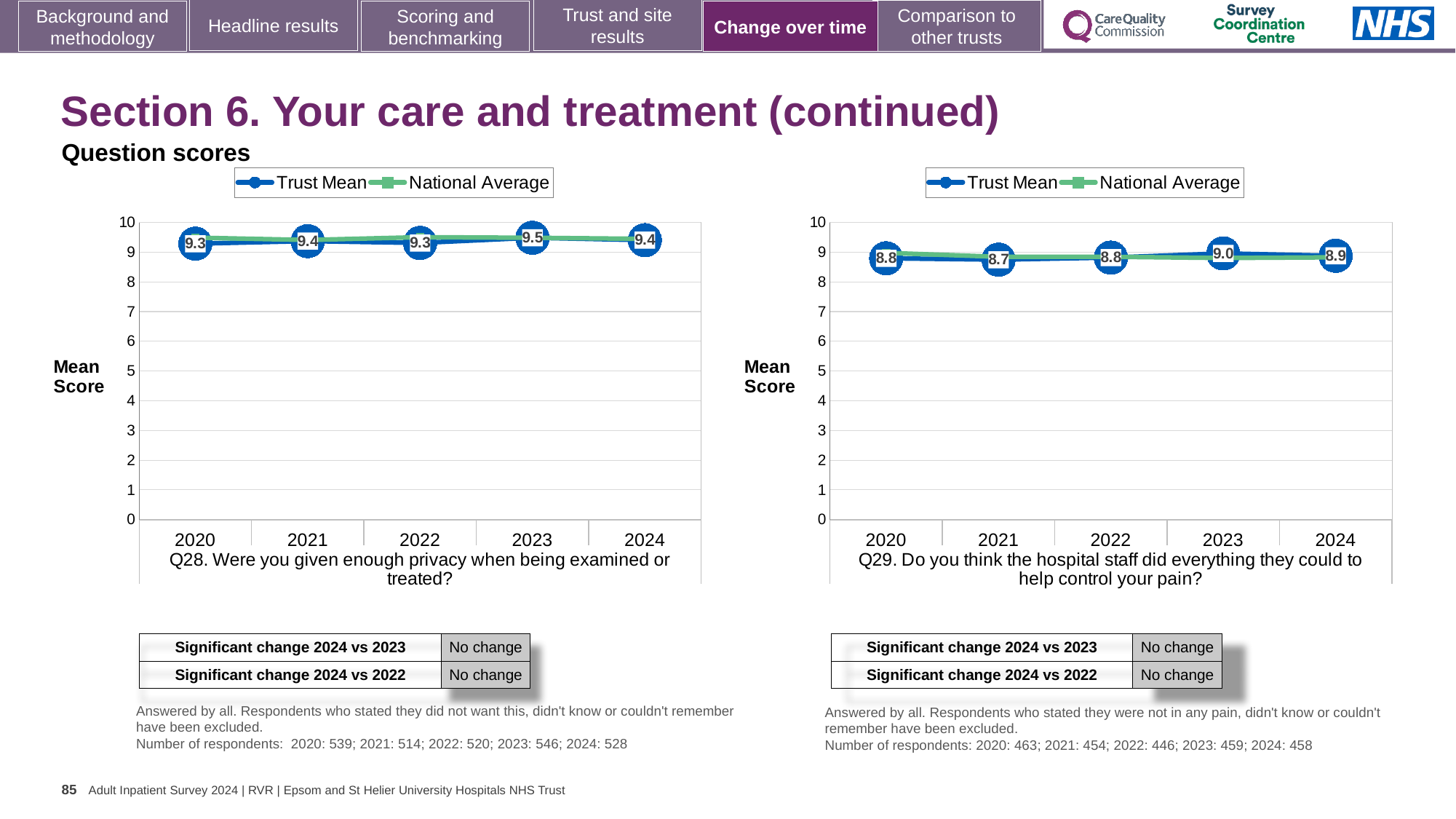
In the Q29 chart (right), what is the Trust Mean score for 2021? 8.7 In the Q28 chart (left), what is the Trust Mean score for 2023? 9.5 In the Q28 chart (left), what is the Trust Mean score for 2020? 9.3 What type of chart is used for Q28 (left)? Line chart In the Q28 chart (left), is the Trust Mean score for 2024 higher or lower than for 2023? lower In the Q28 chart (left), which year has the highest Trust Mean score? 2023 How many series does the legend of the Q28 chart (left) list? 2 In the Q29 chart (right), what is the difference between the Trust Mean scores for 2023 and 2021? 0.3 In the Q29 chart (right), which year has the lowest Trust Mean score? 2021 How many years are plotted on the x axis of the Q29 chart (right)? 5 In the Q29 chart (right), what is the Trust Mean score for 2024? 8.9 In the Q29 chart (right), what is the label of the y axis? Mean Score